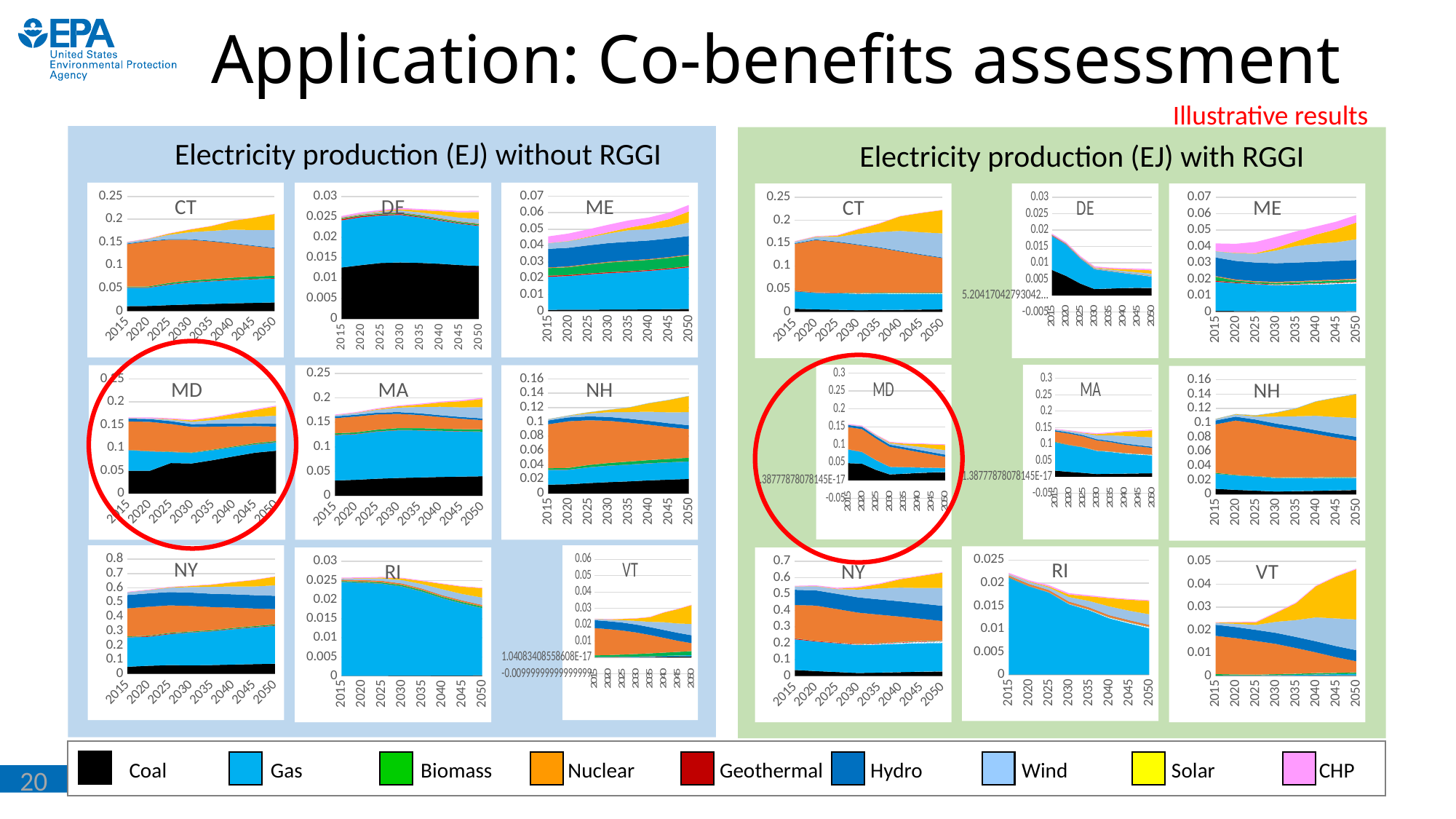
According to the legend, which colour represents Coal? black In the VT chart of the 'with RGGI' panel, is the total value in 2050 greater or less than 0.04? greater In the NY chart of the 'without RGGI' panel, does total electricity production rise or fall from 2015 to 2050? rise How many years are marked on the x axis of the NY chart in the 'without RGGI' panel? 8 What kind of chart is used for each state panel on the slide? stacked area chart In the 'with RGGI' panel, which state's chart is circled in red? MD How many state charts are shown in the 'Electricity production (EJ) without RGGI' panel? 9 In the MD chart of the 'with RGGI' panel, is the total value in 2050 greater or less than 0.15? less In the RI chart of the 'with RGGI' panel, is the total value in 2050 greater or less than 0.02? less How many series does the legend at the bottom of the slide list? 9 In the MD chart of the 'with RGGI' panel, does total electricity production rise or fall from 2015 to 2050? fall